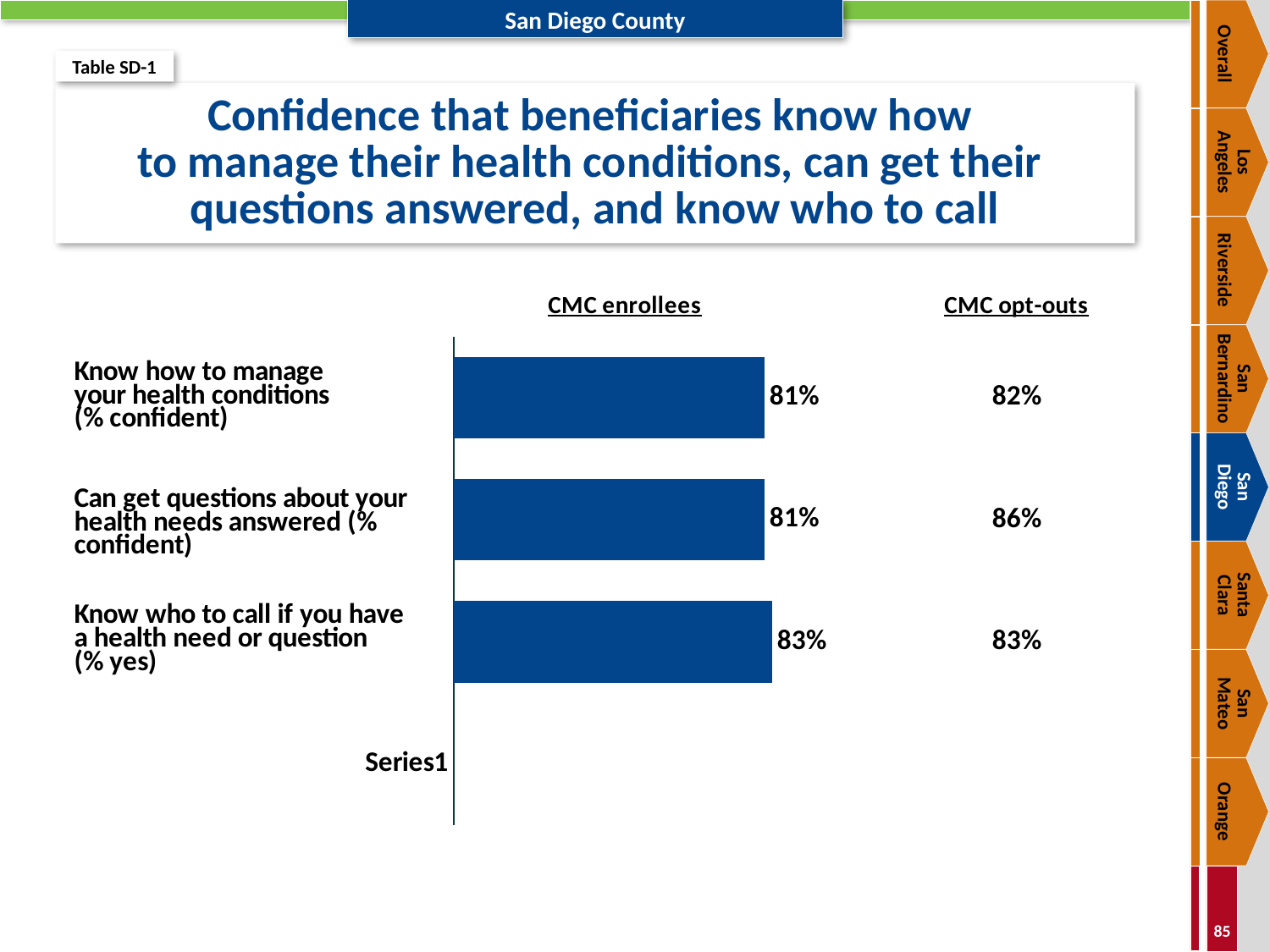
What is the table label shown in the top-left corner of the slide? Table SD-1 What percentage of CMC enrollees say they know who to call if they have a health need or question? 83% What are the two column headings shown above the values? CMC enrollees and CMC opt-outs What percentage of CMC enrollees are confident they know how to manage their health conditions? 81% What is the difference between the CMC enrollees values for 'Know who to call if you have a health need or question' and 'Know how to manage your health conditions'? 2 percentage points What type of chart is shown on the slide? Bar chart How many bars are plotted in the chart? 3 What is the difference between the CMC opt-outs and CMC enrollees values for 'Can get questions about your health needs answered'? 5 percentage points For 'Know how to manage your health conditions', which group has the higher value, CMC enrollees or CMC opt-outs? CMC opt-outs What percentage of CMC opt-outs are confident they can get questions about their health needs answered? 86% What percentage of CMC enrollees are confident they can get questions about their health needs answered? 81% Which item has the highest value among CMC enrollees? Know who to call if you have a health need or question